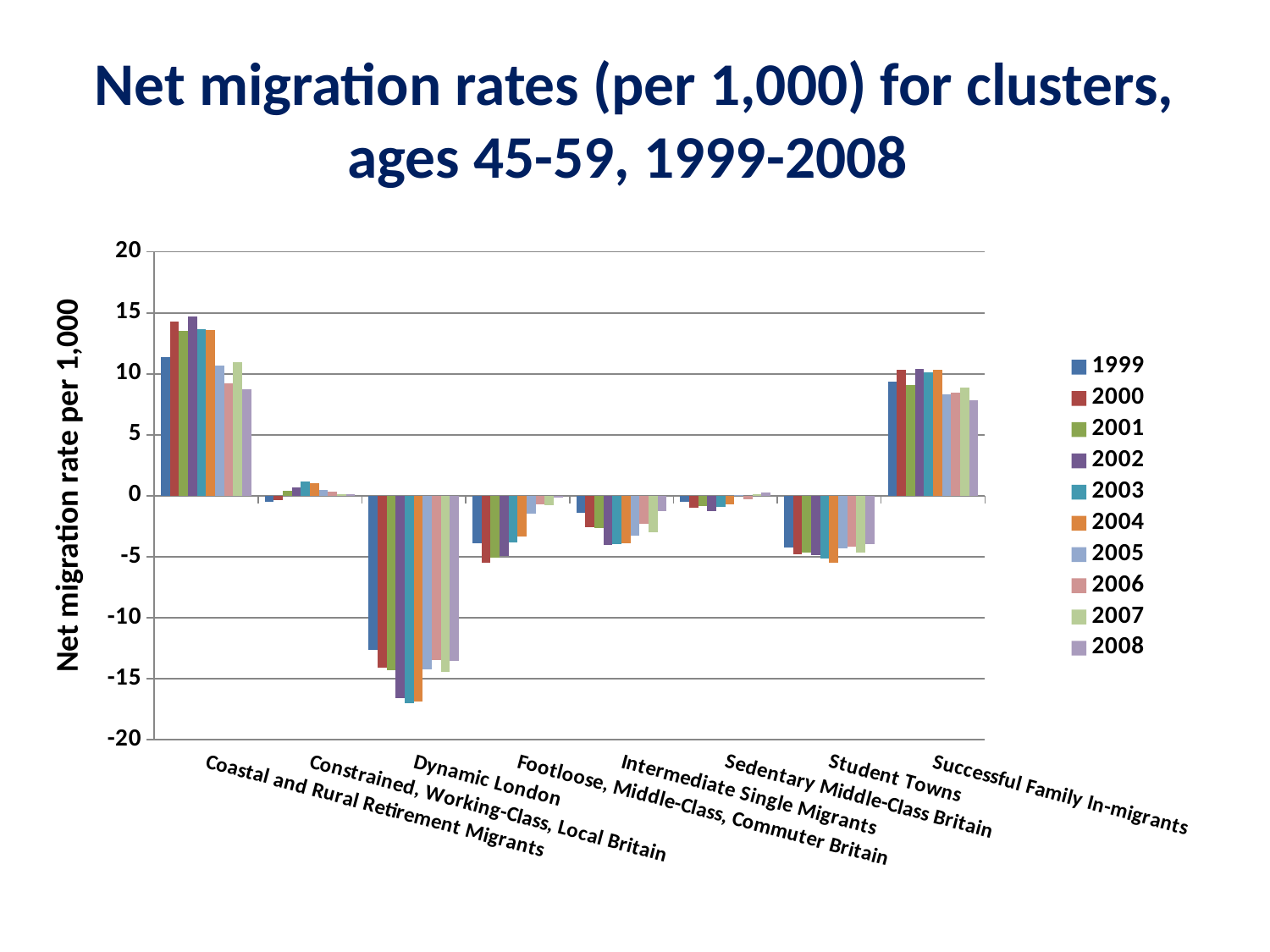
Is the 2003 value for Dynamic London greater or less than -15? less Is the 2002 value for Coastal and Rural Retirement Migrants greater or less than 10? greater What is the title of the chart? Net migration rates (per 1,000) for clusters, ages 45-59, 1999-2008 How many series does the legend list? 10 What kind of chart is shown on the slide? bar chart Which cluster has the highest net migration rates? Coastal and Rural Retirement Migrants Which cluster has the lowest (most negative) net migration rates? Dynamic London Is the 1999 value for Dynamic London greater or less than -10? less Which is larger in 2002: the value for Coastal and Rural Retirement Migrants or the value for Successful Family In-migrants? Coastal and Rural Retirement Migrants What is the label on the y axis? Net migration rate per 1,000 How many clusters (categories) are shown on the x axis? 8